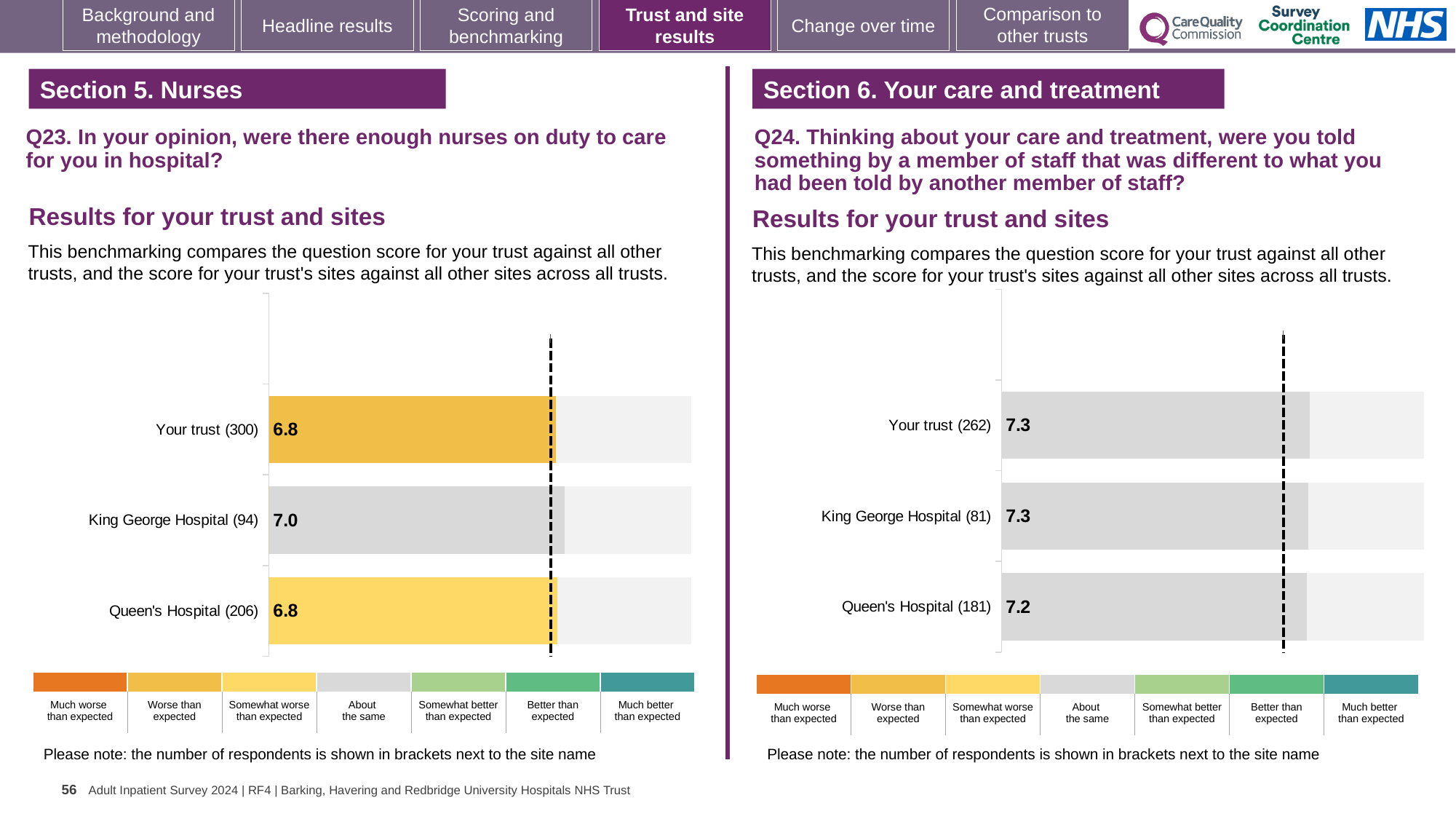
In the Q23 chart on the left, how many respondents are shown for Queen's Hospital? 206 In the Q24 chart on the right, is the score for King George Hospital larger or smaller than the score for Queen's Hospital? larger What type of chart is used for the Q23 results on the left? Bar chart In the Q23 chart on the left, what is the score for Queen's Hospital? 6.8 In the Q23 chart on the left, what is the score for Your trust? 6.8 In the Q24 chart on the right, what is the score for Your trust? 7.3 In the Q23 chart on the left, which site or trust has the highest score? King George Hospital In the Q24 chart on the right, what is the score for Queen's Hospital? 7.2 In the Q24 chart on the right, which site has the lowest score? Queen's Hospital In the Q23 chart on the left, what is the difference between the King George Hospital score and the Your trust score? 0.2 In the Q23 chart on the left, what is the score for King George Hospital? 7.0 How many bars are plotted in the Q24 chart on the right? 3